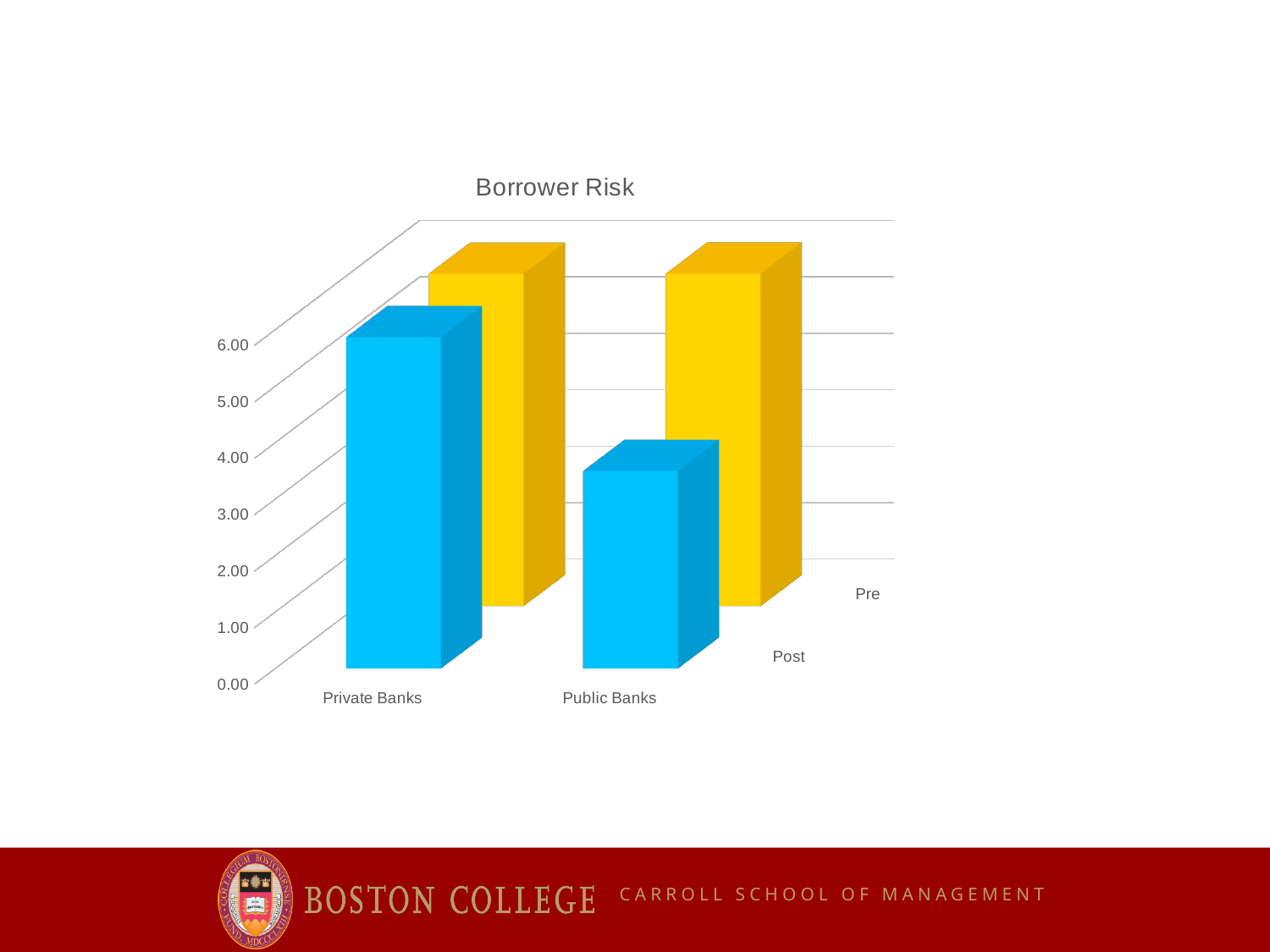
Which bar on the chart is the lowest? Public Banks, Post Is the Post value for Public Banks greater or less than 2.00? greater How many series (Pre and Post) does the chart plot? 2 How many bank categories are shown on the chart? 2 What kind of chart is shown on the slide? bar chart Which series is drawn in yellow, Pre or Post? Pre What is the title of the chart? Borrower Risk Is the Pre value for Public Banks greater or less than 4.00? greater For Public Banks, which is larger, the Pre value or the Post value? Pre For the Post series, which category has the larger value, Private Banks or Public Banks? Private Banks Is the Post value for Public Banks greater or less than 5.00? less